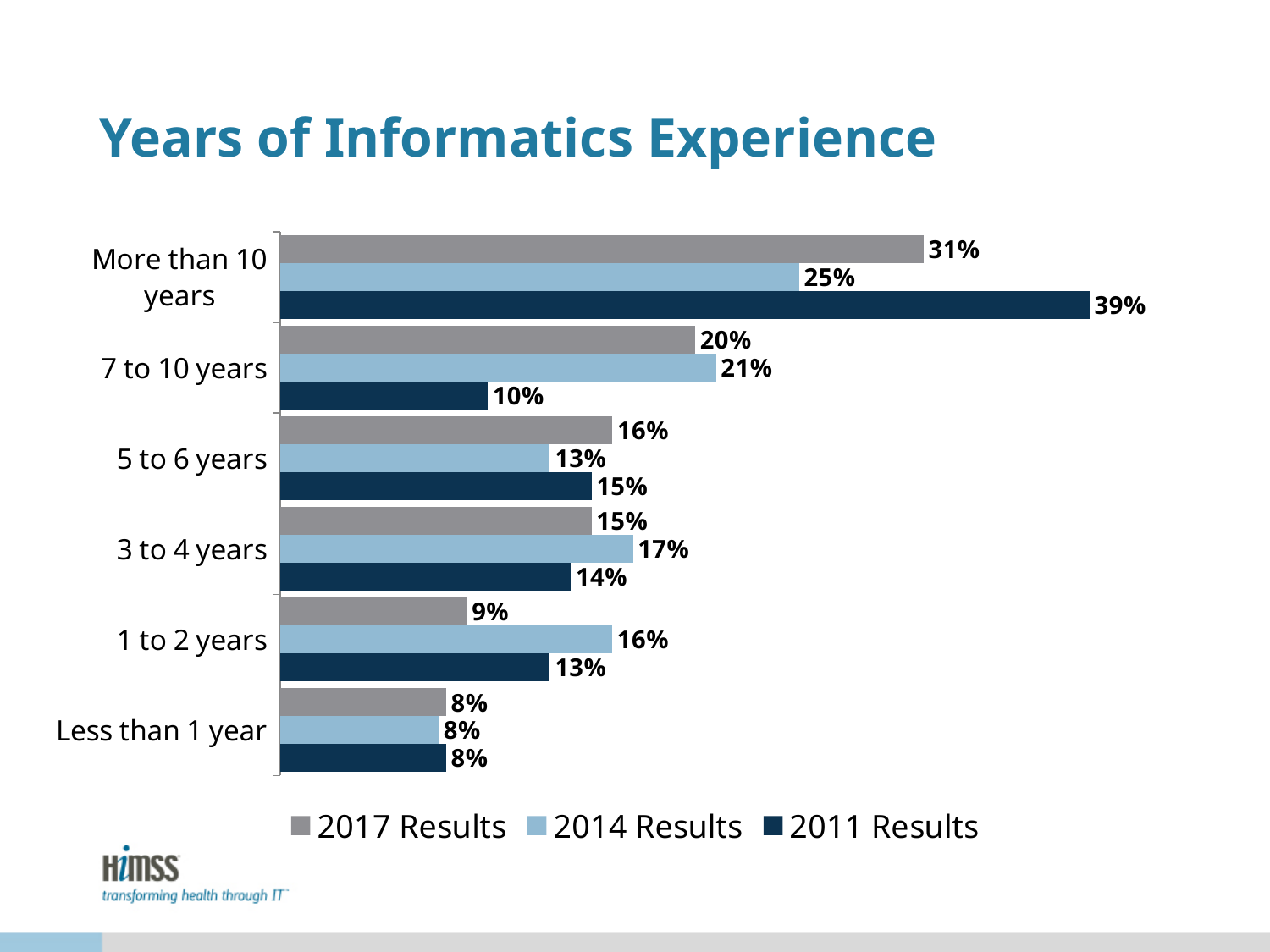
How many experience categories are shown on the chart? 6 What percentage of respondents had more than 10 years of informatics experience in the 2017 Results? 31% What percentage of respondents had 7 to 10 years of informatics experience in the 2011 Results? 10% Which experience category has the lowest value in the 2017 Results series? Less than 1 year What is the title of the chart on the slide? Years of Informatics Experience What kind of chart is shown on the slide? Bar chart What percentage of respondents had 1 to 2 years of informatics experience in the 2014 Results? 16% How many series does the legend list? 3 Which colour represents the 2014 Results series in the legend? Light blue Which experience category has the highest value in the 2011 Results series? More than 10 years Which is larger for 7 to 10 years: the 2014 Results value or the 2011 Results value? 2014 Results What is the difference between the 2011 Results and 2017 Results values for More than 10 years? 8%